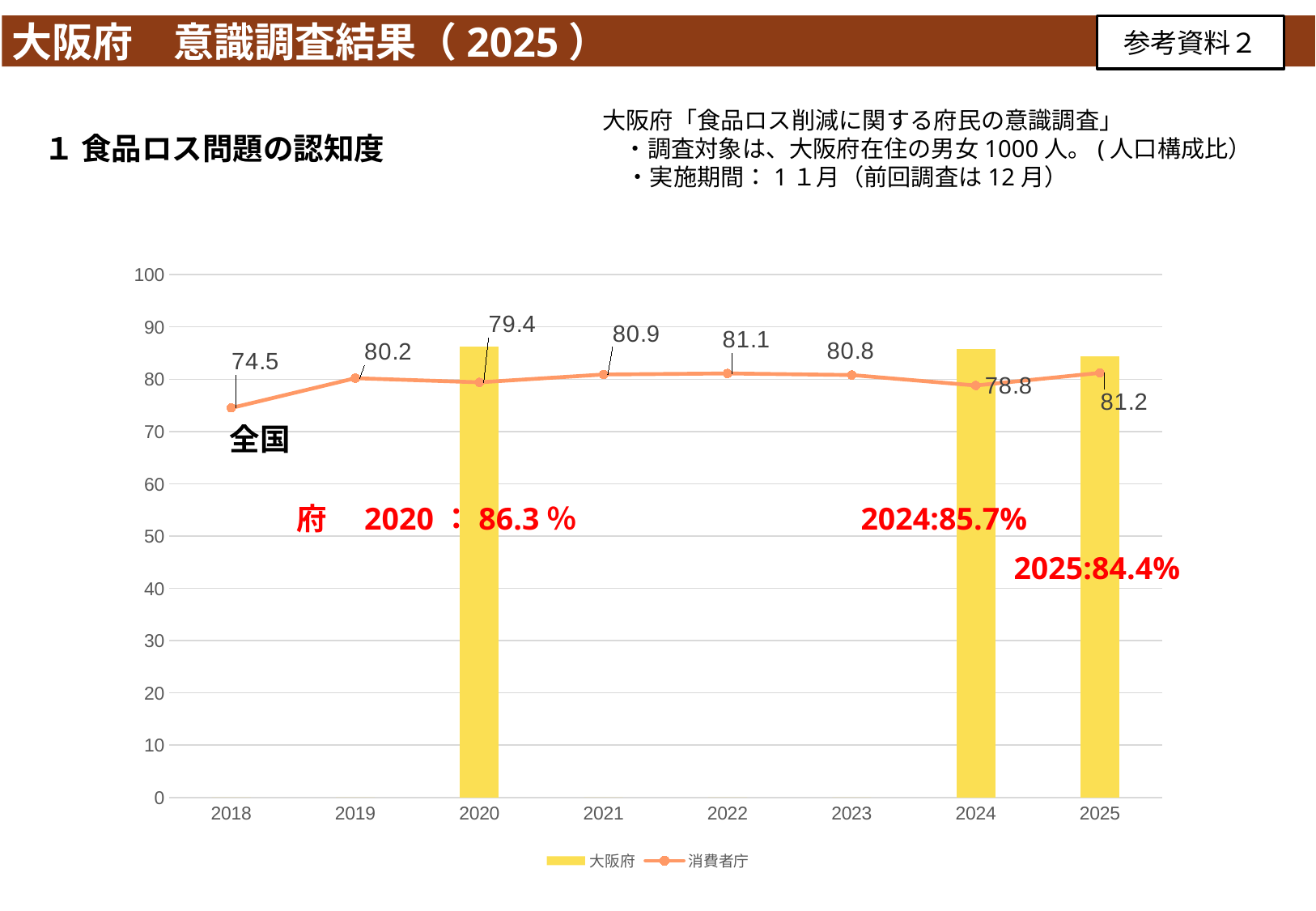
Which is larger, the 大阪府 value for 2024 or the 消費者庁 value for 2024? 大阪府 value for 2024 In which year is the 消費者庁 value the lowest? 2018 How many years are shown on the x axis? 8 What is the 大阪府 value for 2025 as annotated on the chart? 84.4% How many series does the legend list? 2 What is the 消費者庁 value for 2022? 81.1 What is the 消費者庁 value for 2024? 78.8 Which series is drawn as bars in the chart? 大阪府 What is the 大阪府 value for 2020 as annotated on the chart? 86.3％ What is the 消費者庁 value for 2018? 74.5 In which year is the 消費者庁 value the highest? 2025 What is the difference between the 消費者庁 values for 2019 and 2018? 5.7